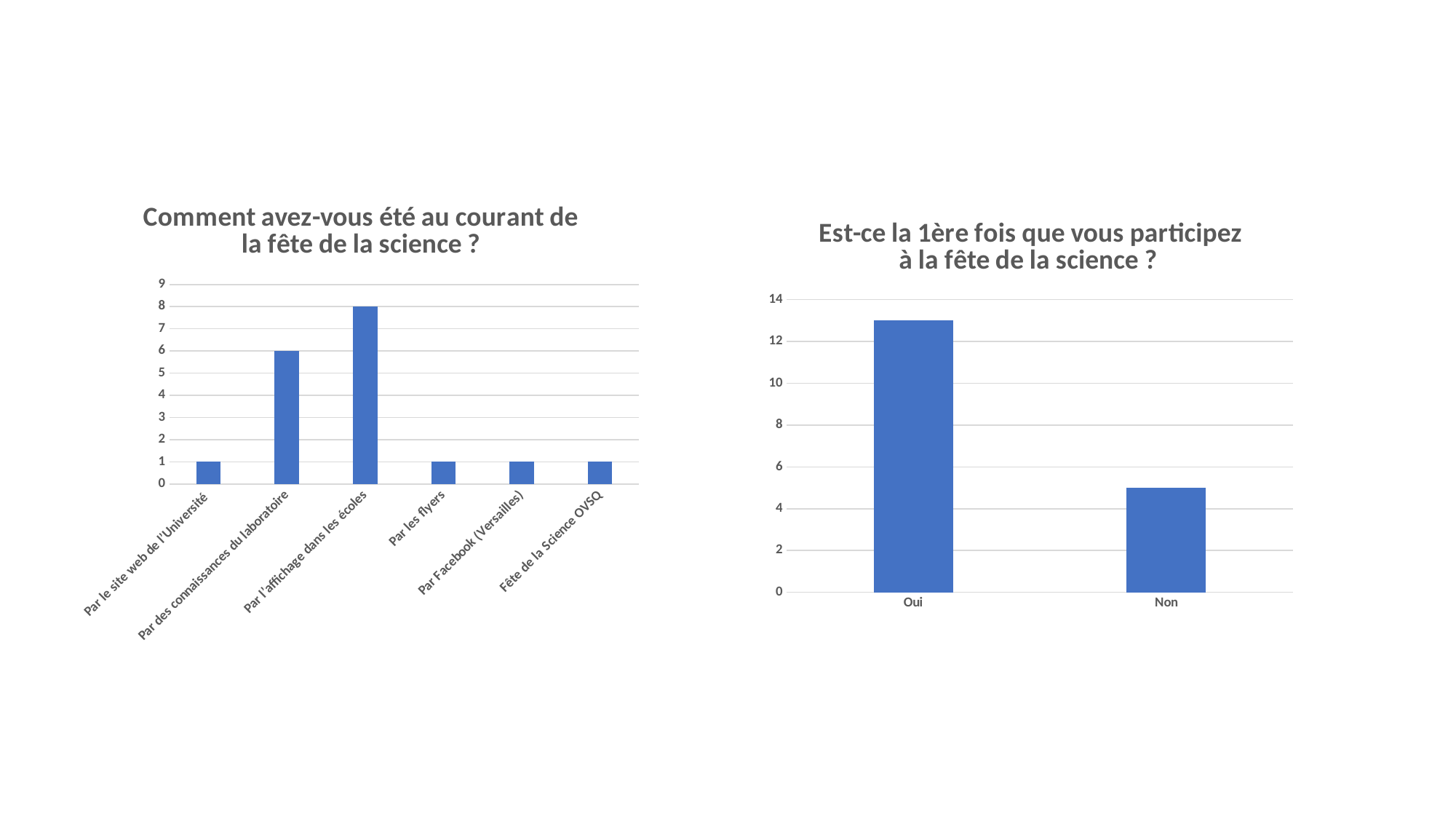
In the chart titled "Comment avez-vous été au courant de la fête de la science ?", how many categories are shown on the x axis? 6 In the chart titled "Comment avez-vous été au courant de la fête de la science ?", which category has the highest value? Par l'affichage dans les écoles What kind of chart is the one on the right of the slide? Bar chart In the chart titled "Est-ce la 1ère fois que vous participez à la fête de la science ?", is the value for "Oui" greater or less than 12? greater In the chart titled "Comment avez-vous été au courant de la fête de la science ?", what is the value for "Par les flyers"? 1 In the chart titled "Comment avez-vous été au courant de la fête de la science ?", what is the value for "Par l'affichage dans les écoles"? 8 In the chart titled "Comment avez-vous été au courant de la fête de la science ?", what is the value for "Par des connaissances du laboratoire"? 6 In the chart titled "Est-ce la 1ère fois que vous participez à la fête de la science ?", how many categories are shown on the x axis? 2 In the chart titled "Est-ce la 1ère fois que vous participez à la fête de la science ?", which category has the lowest value? Non In the chart titled "Est-ce la 1ère fois que vous participez à la fête de la science ?", is the value for "Non" greater or less than 6? less In the chart titled "Comment avez-vous été au courant de la fête de la science ?", what is the difference between "Par l'affichage dans les écoles" and "Par des connaissances du laboratoire"? 2 In the chart titled "Comment avez-vous été au courant de la fête de la science ?", which is larger: "Par des connaissances du laboratoire" or "Par Facebook (Versailles)"? Par des connaissances du laboratoire